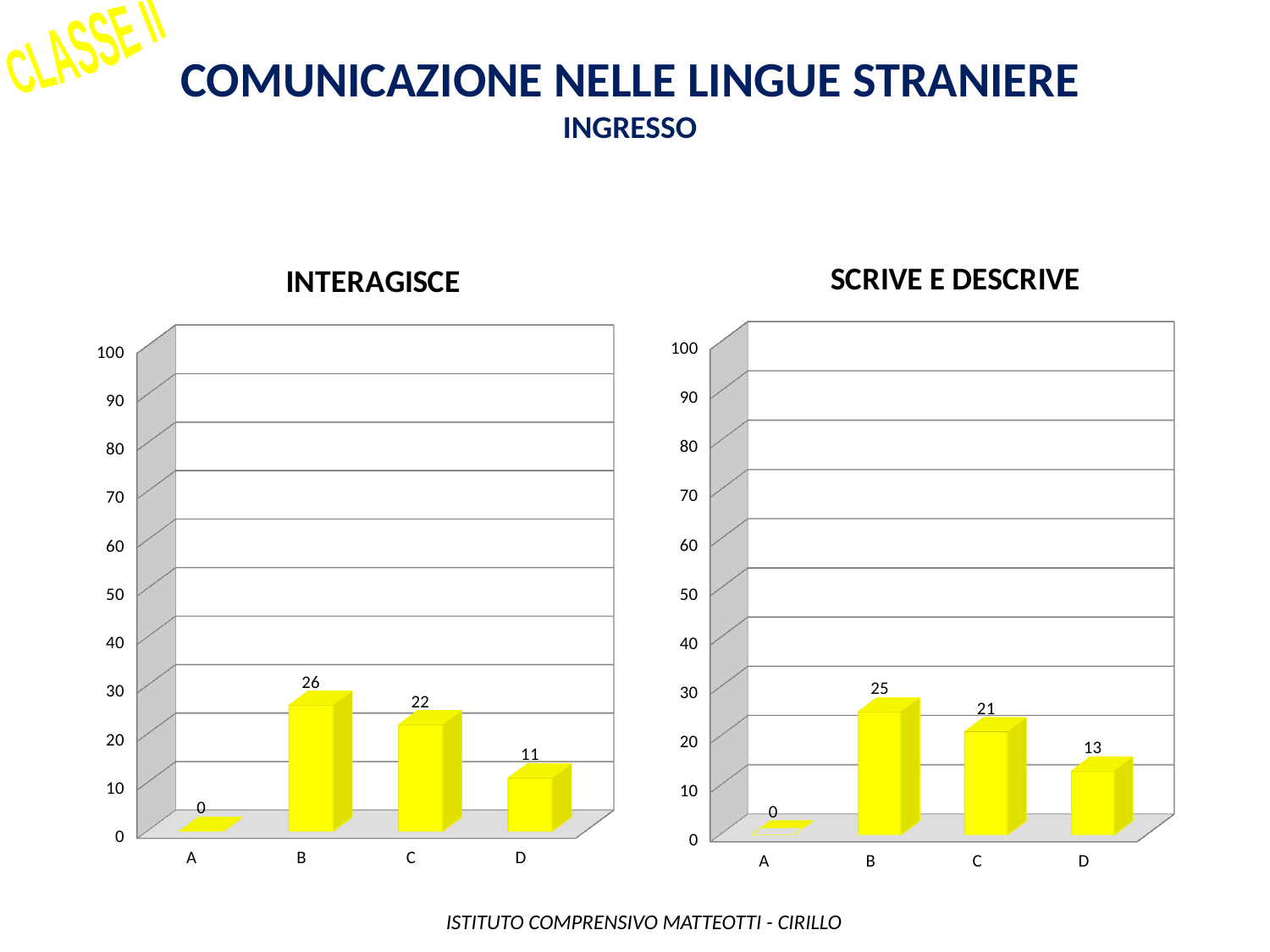
How many categories are shown on the x axis of the INTERAGISCE chart? 4 In the INTERAGISCE chart, is the value for B greater or less than 30? less In the SCRIVE E DESCRIVE chart, what is the value for category A? 0 In the SCRIVE E DESCRIVE chart, what is the value for category C? 21 In the INTERAGISCE chart, what is the difference between the values for B and C? 4 In the SCRIVE E DESCRIVE chart, what is the difference between the values for B and D? 12 In the SCRIVE E DESCRIVE chart, which category has the lowest value? A In the INTERAGISCE chart, which category has the highest value? B In the INTERAGISCE chart, what is the value for category D? 11 In the SCRIVE E DESCRIVE chart, which is larger, the value for C or the value for D? C In the INTERAGISCE chart, what is the value for category B? 26 What kind of chart is the SCRIVE E DESCRIVE chart? bar chart